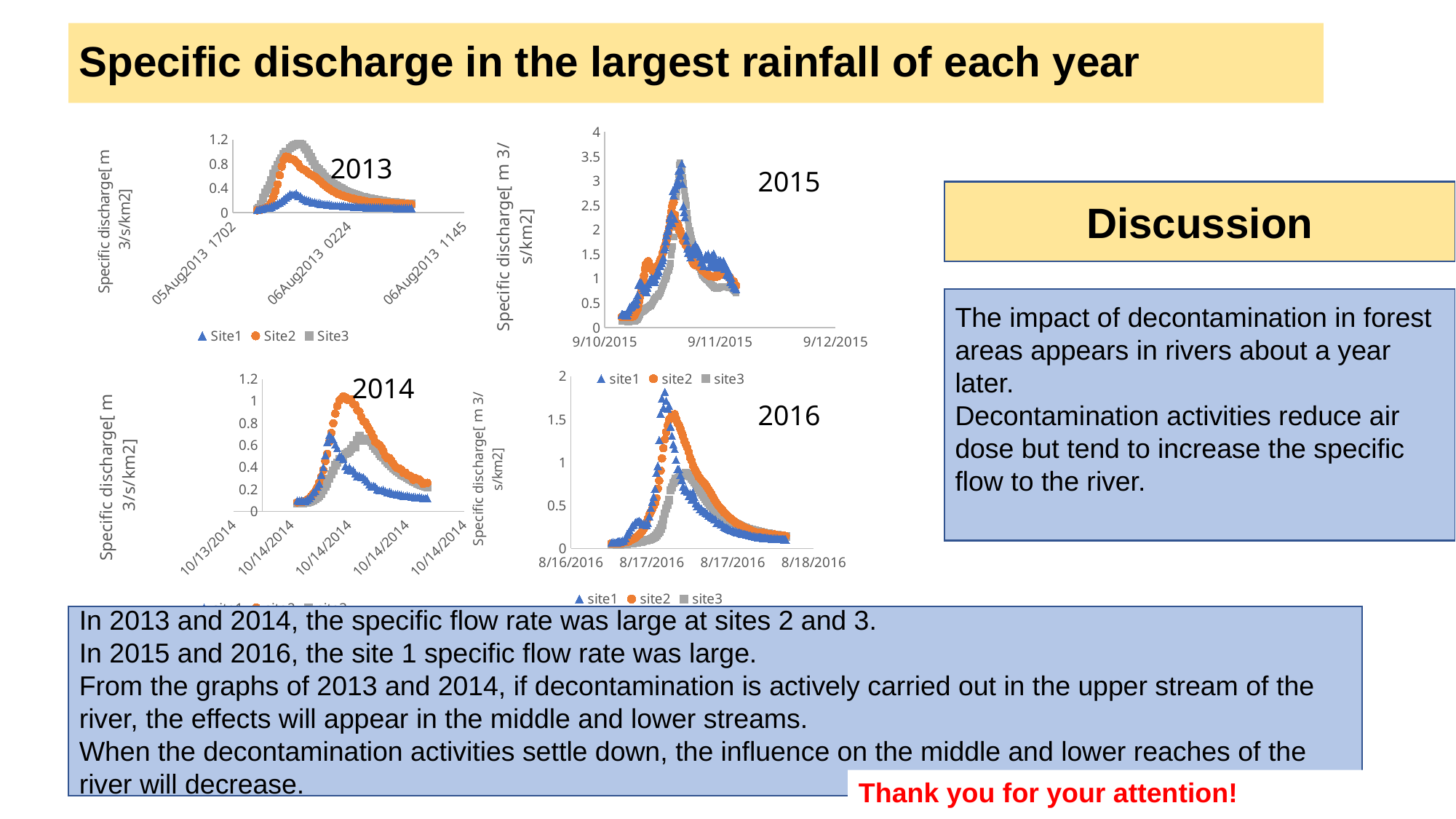
In the 2013 chart, is the peak value for Site1 greater or less than 0.4? less In the 2013 chart, which site reaches the highest peak specific discharge? Site3 In the 2013 chart, which site has the lowest peak specific discharge? Site1 What kind of chart is the 2013 chart? scatter chart How many series does the legend of the 2015 chart list? 3 In the 2014 chart, is the peak value for Site2 greater or less than 0.8? greater How many charts are shown on the slide? 4 In the 2016 chart, is the peak value for site3 greater or less than 1? less In the 2016 chart, which site has the lowest peak specific discharge? site3 In the 2014 chart, which site reaches the highest peak specific discharge? Site2